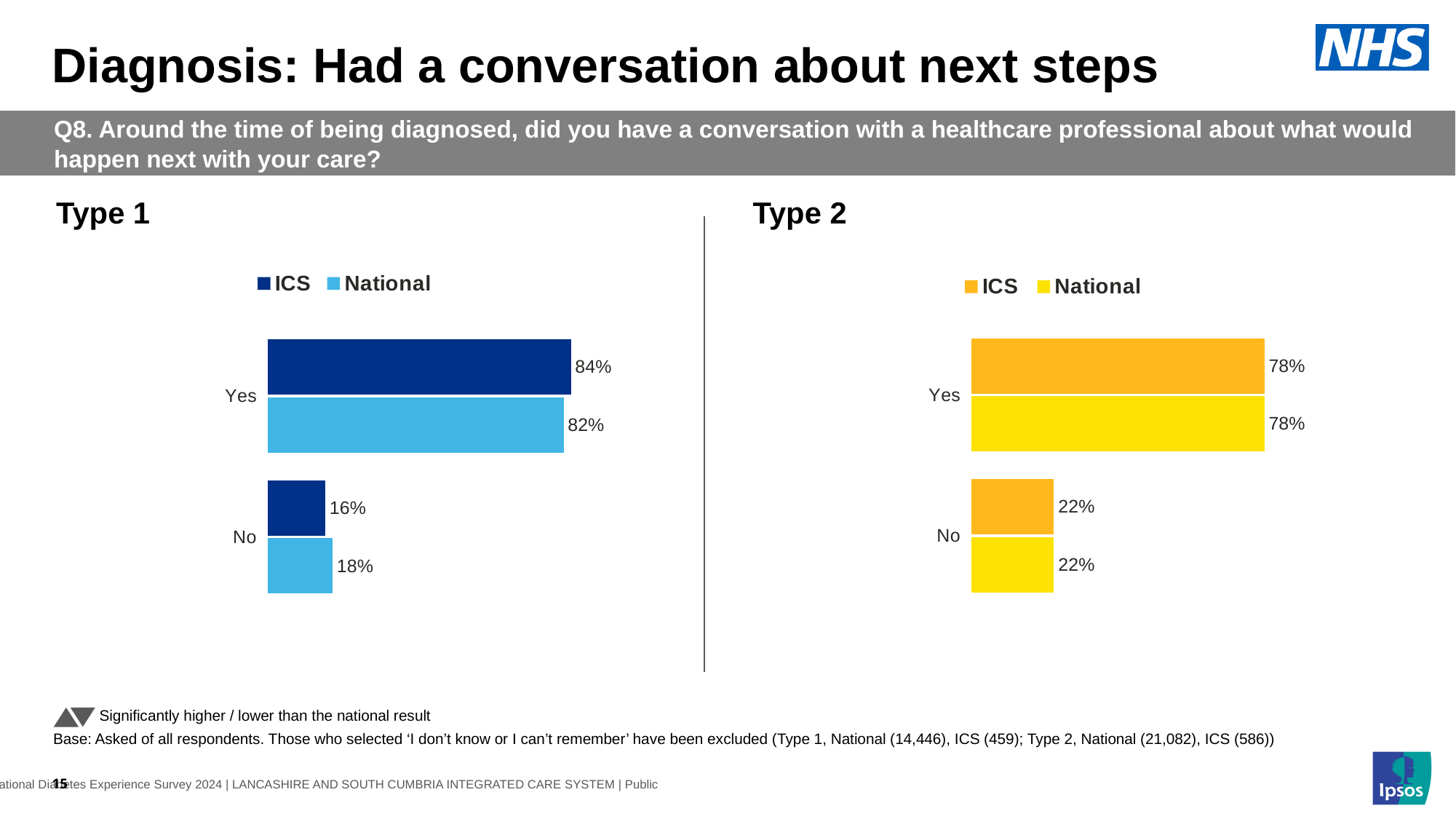
In the Type 1 chart, which is larger for No: ICS or National? National In the Type 1 chart, what is the difference between the ICS and National values for Yes? 2 percentage points In the Type 2 chart, what colour represents the National series? Yellow In the Type 1 chart, which category has the highest ICS value? Yes How many categories are shown in the Type 2 chart? 2 How many series does the legend of the Type 1 chart list? 2 In the Type 1 chart, what is the National value for No? 18% In the Type 1 chart, what is the ICS value for Yes? 84% In the Type 2 chart, which category has the lowest National value? No In the Type 2 chart, what is the ICS value for No? 22% What kind of chart is the Type 2 chart? Bar chart In the Type 2 chart, what is the National value for Yes? 78%